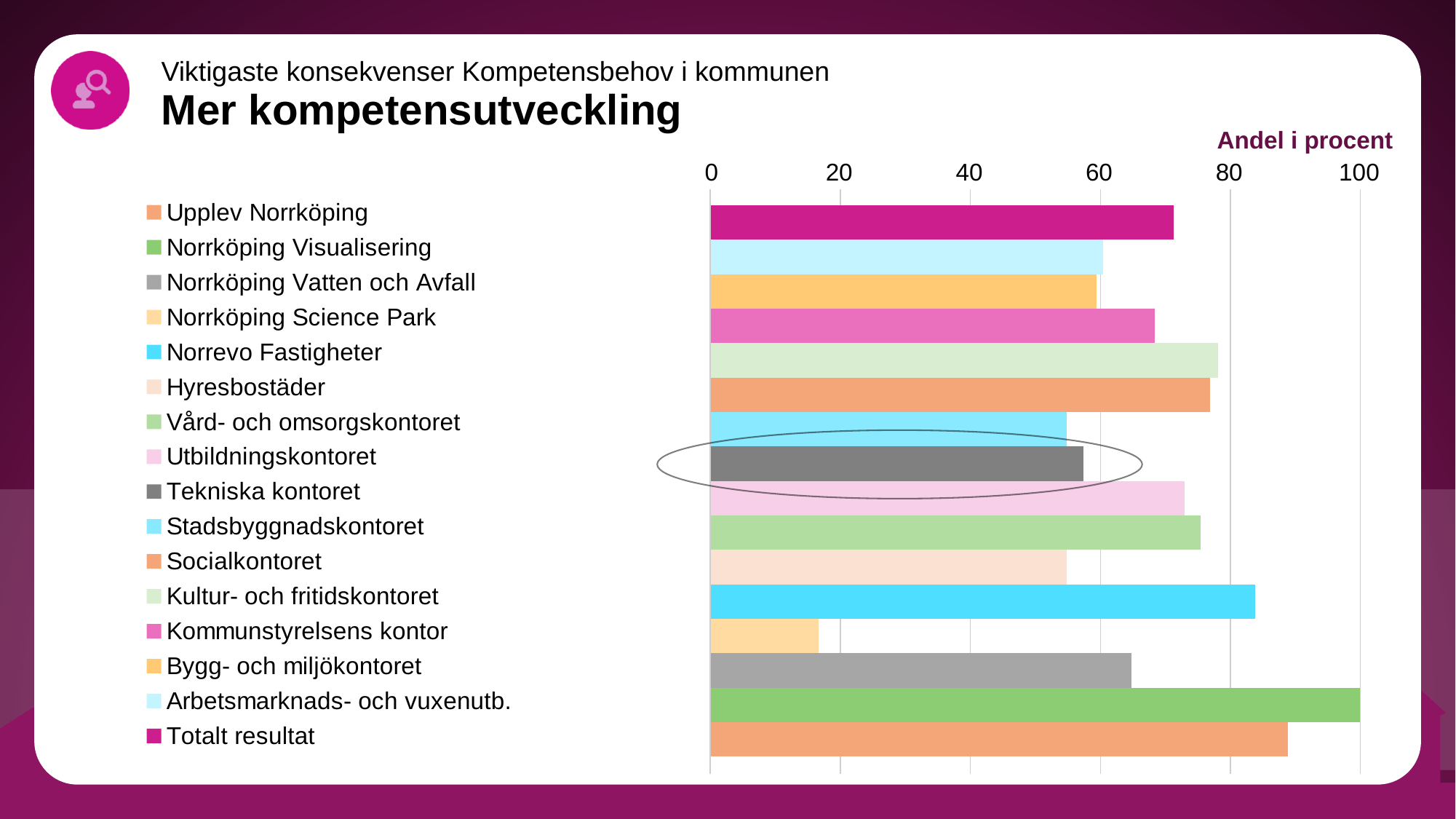
What is the label shown above the horizontal axis of the chart? Andel i procent Is the value for Totalt resultat greater or less than 60? greater What is the value for Norrköping Visualisering? 100 Is the value for Norrköping Science Park greater or less than 20? less Is the value for Hyresbostäder greater or less than 60? less What kind of chart is shown on the slide? bar chart Which category has the highest value? Norrköping Visualisering Which is larger, the value for Norrevo Fastigheter or the value for Totalt resultat? Norrevo Fastigheter How many entries does the legend list? 16 Which is larger, the value for Upplev Norrköping or the value for Norrköping Vatten och Avfall? Upplev Norrköping Which category has the lowest value? Norrköping Science Park